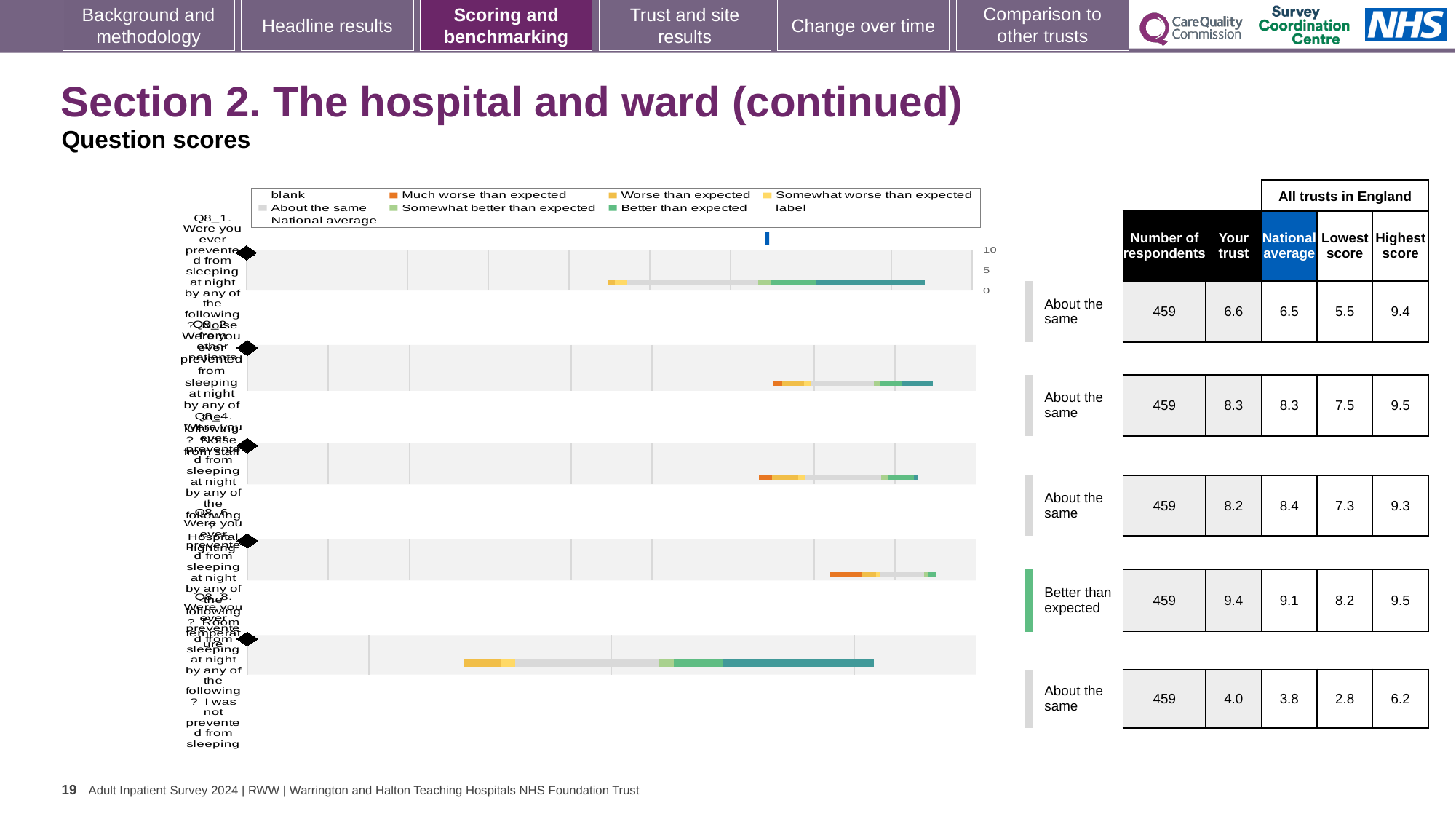
How many respondents are listed for each question in the table? 459 How many question rows (bars) does the chart show? 5 Which row is rated 'Better than expected' rather than 'About the same'? Q8_6 (fourth row) Which row has the lowest 'Your trust' score in the table? Q8_8 (fifth row), 4.0 How many entries does the chart legend list? 9 In the table next to the chart, what is the 'Your trust' score for the first row (Q8_1)? 6.6 For the fifth row (Q8_8), how much higher is the 'Your trust' score than the national average? 0.2 For the third row (Q8_4), which is larger: the 'Your trust' score or the national average? National average (8.4) What kind of chart is shown on the slide? bar chart What is the highest tick value shown on the chart's axis? 10 Which row has the highest 'Your trust' score in the table? Q8_6 (fourth row), 9.4 In the table next to the chart, what is the national average for the fourth row (Q8_6)? 9.1